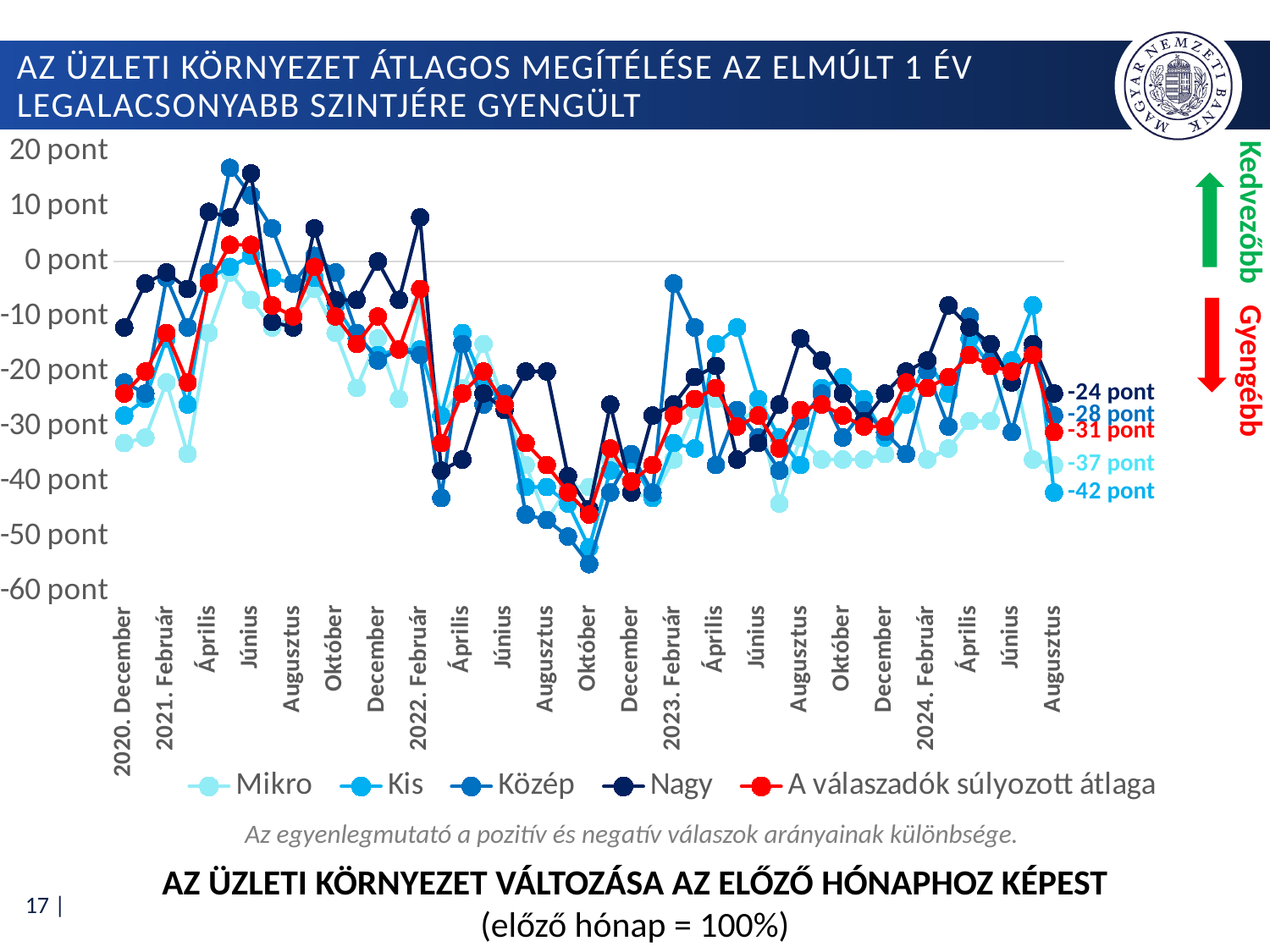
What is the difference between the Nagy and Kis values at the last point (2024 Augusztus)? 18 pont Which series has the lowest value at the last point (2024 Augusztus)? Kis What is the value of the Közép series at the last point (2024 Augusztus)? -28 pont What is the value of the Nagy series at the last point (2024 Augusztus)? -24 pont What kind of chart is shown on the slide? line chart How many series does the legend list? 5 Is the value of 'A válaszadók súlyozott átlaga' in 2022 Október greater or less than -40 pont? less What is the value of 'A válaszadók súlyozott átlaga' at the last point (2024 Augusztus)? -31 pont What is the value of the Kis series at the last point (2024 Augusztus)? -42 pont What is the value of the Mikro series at the last point (2024 Augusztus)? -37 pont Which series is drawn in red? A válaszadók súlyozott átlaga Which series has the highest value at the last point (2024 Augusztus)? Nagy